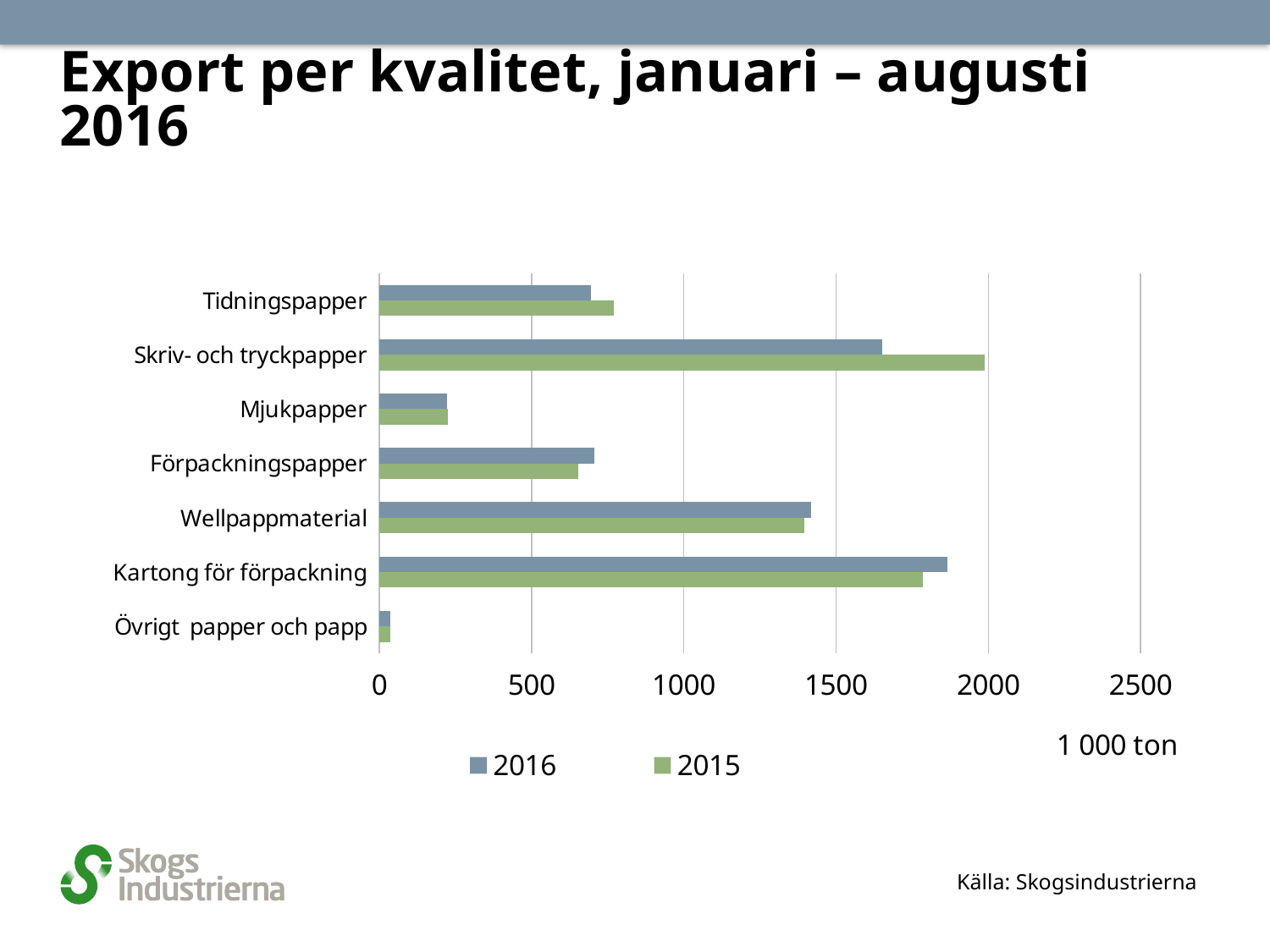
How many product categories are shown on the chart? 7 What unit is shown for the values on the chart? 1 000 ton Which category has the highest value for 2015? Skriv- och tryckpapper How many series does the legend list? 2 Is the 2016 value for Tidningspapper greater or less than 1000? less Which category has the highest value for 2016? Kartong för förpackning For Skriv- och tryckpapper, which year has the larger value, 2016 or 2015? 2015 Which category has the lowest value for 2016? Övrigt papper och papp Is the 2015 value for Skriv- och tryckpapper greater or less than 1500? greater Is the 2016 value for Mjukpapper greater or less than 500? less What kind of chart is shown on the slide? Bar chart For Kartong för förpackning, which year has the larger value, 2016 or 2015? 2016